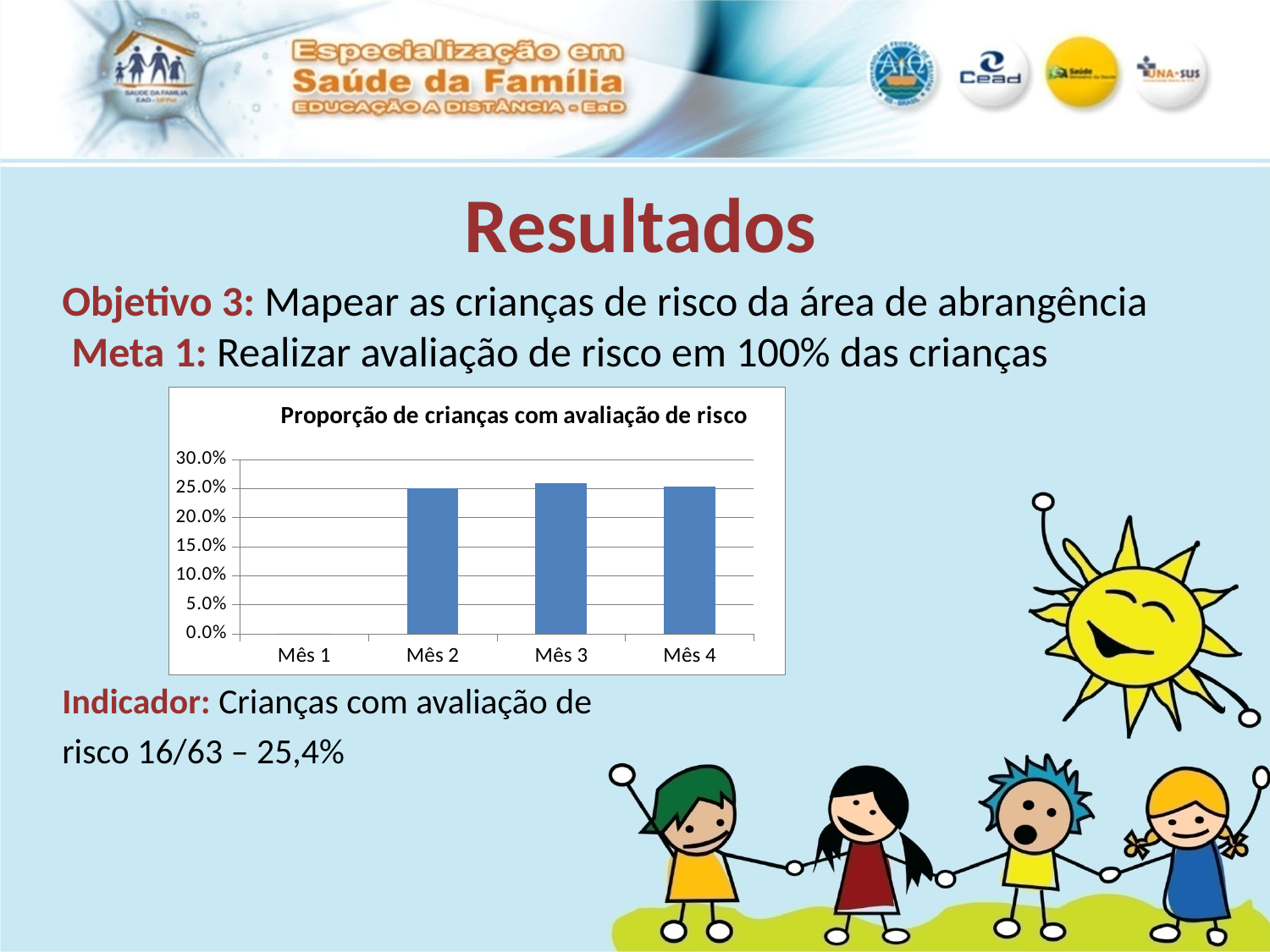
Does the value rise or fall from Mês 1 to Mês 2? rise What is the highest value shown on the y axis of the chart? 30.0% Is the value for Mês 2 greater or less than 20.0%? greater Which is larger, the value for Mês 1 or the value for Mês 2? Mês 2 Is the value for Mês 3 greater or less than 30.0%? less What kind of chart is shown on the slide? bar chart Is the value for Mês 1 greater or less than 5.0%? less How many months (categories) are shown on the x axis of the chart? 4 What is the title of the chart? Proporção de crianças com avaliação de risco Which is larger, the value for Mês 4 or the value for Mês 1? Mês 4 Which month has the lowest value in the chart? Mês 1